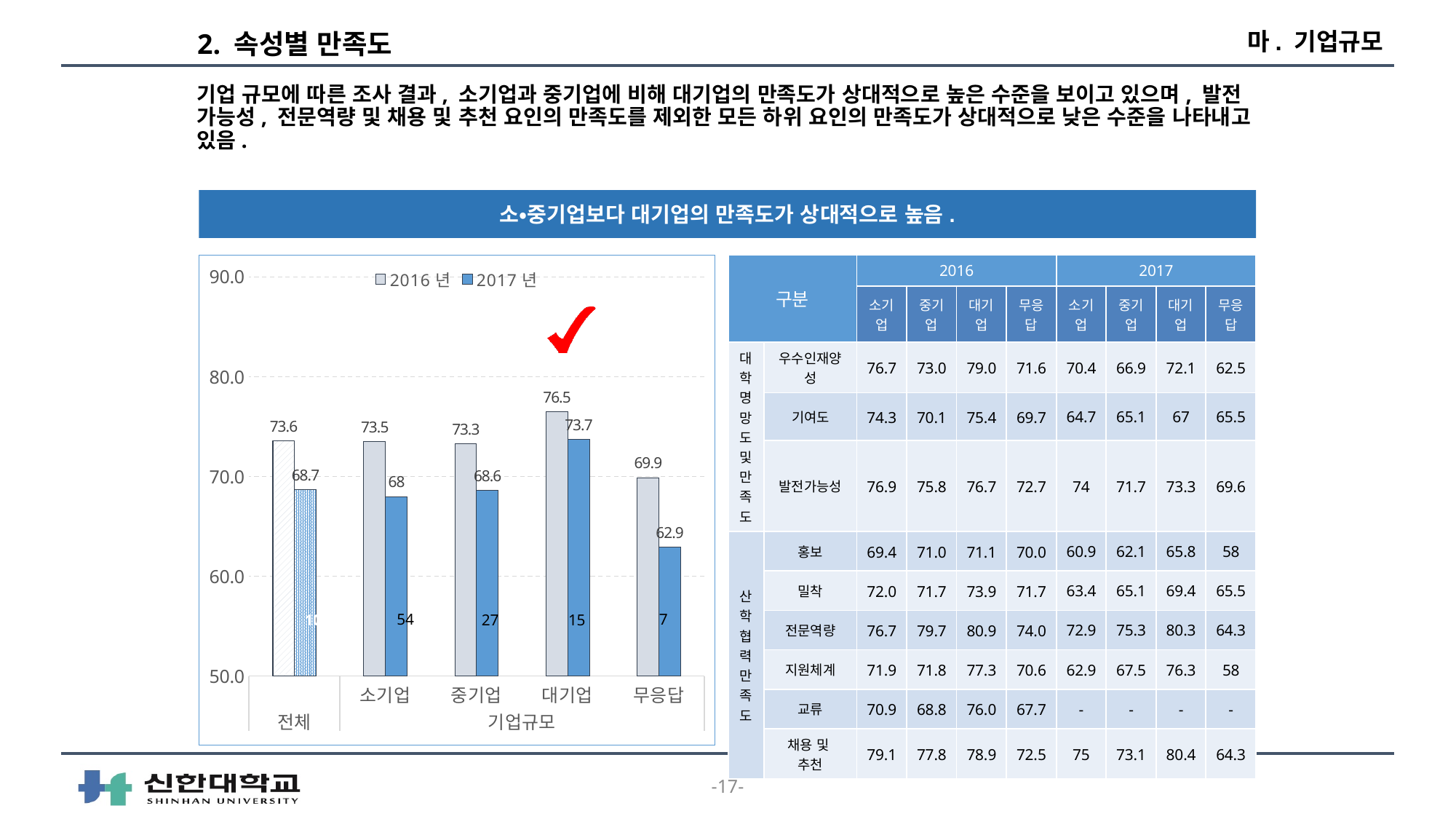
How many categories are shown on the x axis of the chart? 5 What is the 2016년 value for 전체? 73.6 What is the difference between the 2016년 and 2017년 values for 중기업? 4.7 Which is larger, the 2017년 value for 대기업 or the 2017년 value for 소기업? 대기업 What type of chart is shown on the slide? bar chart What is the 2016년 value for 대기업? 76.5 Which category has the lowest 2016년 value? 무응답 Which category has the highest 2017년 value? 대기업 What is the 2017년 value for 소기업? 68 Is the 2017년 value for 무응답 greater or less than 70.0? less What is the 2017년 value for 무응답? 62.9 How many series does the chart legend list? 2